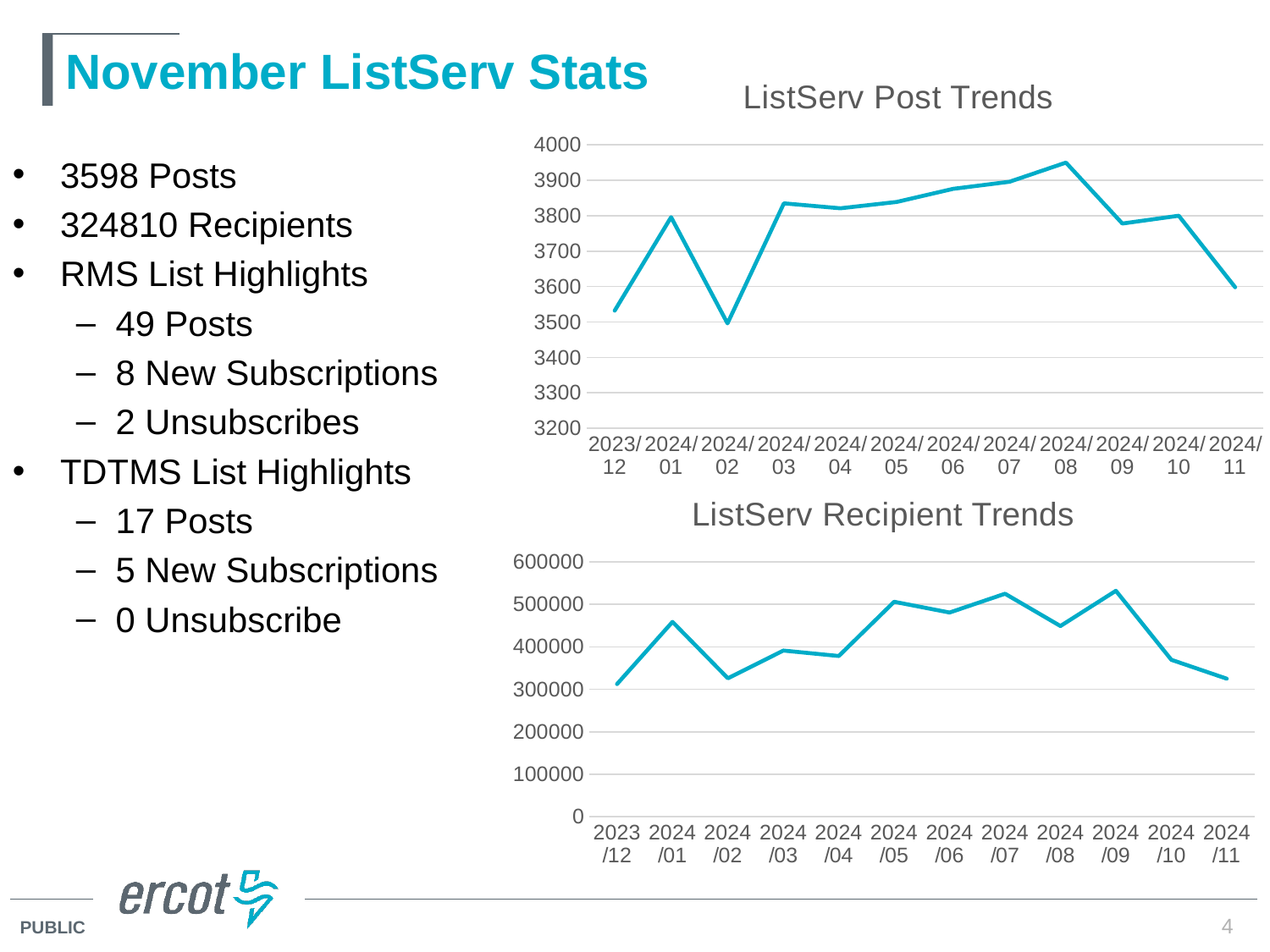
How many data points are plotted in the ListServ Post Trends chart? 12 What type of chart is the ListServ Post Trends chart? line chart In the ListServ Post Trends chart, is the value for 2024/08 greater or less than 3900? greater In the ListServ Post Trends chart, which month has the lowest value? 2024/02 In the ListServ Post Trends chart, is the value for 2024/11 greater or less than 3700? less In the ListServ Post Trends chart, which is larger, the value for 2024/01 or the value for 2024/02? 2024/01 In the ListServ Recipient Trends chart, do the values rise or fall from 2024/09 to 2024/11? fall In the ListServ Post Trends chart, which month has the highest value? 2024/08 In the ListServ Post Trends chart, do the values rise or fall from 2024/08 to 2024/11? fall In the ListServ Recipient Trends chart, is the value for 2024/09 greater or less than 500000? greater How many data points are plotted in the ListServ Recipient Trends chart? 12